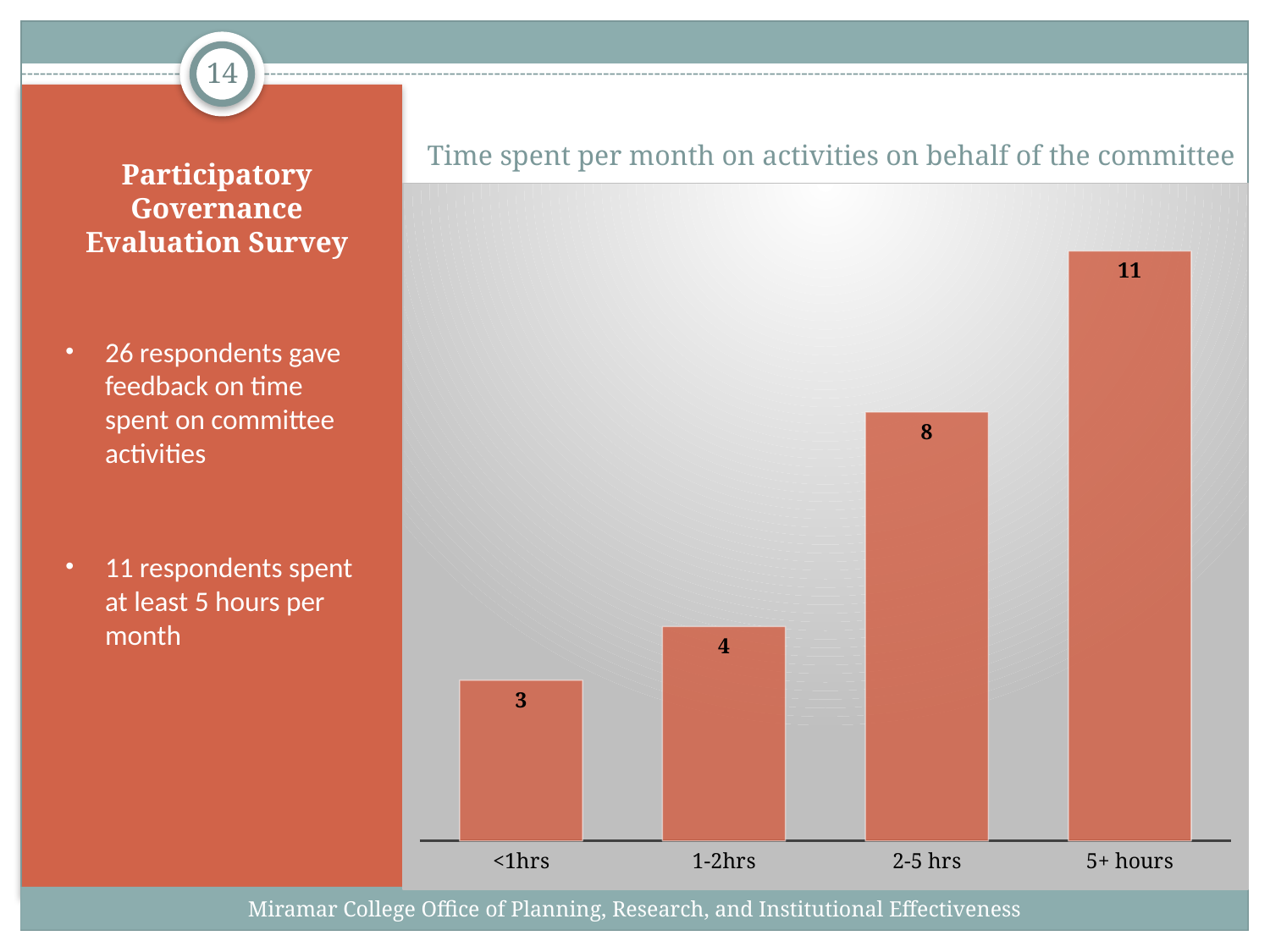
What is the value for the 2-5 hrs category? 8 Which category has the highest value? 5+ hours What kind of chart is shown on the slide? bar chart What is the difference between the values for 5+ hours and 2-5 hrs? 3 What is the value for the 5+ hours category? 11 Which is larger, the value for 1-2hrs or the value for 2-5 hrs? 2-5 hrs What is the value for the 1-2hrs category? 4 Which category has the lowest value? <1hrs How many categories are shown on the x axis? 4 What is the difference between the values for 2-5 hrs and <1hrs? 5 What is the value for the <1hrs category? 3 Do the values rise or fall from left to right along the x axis? rise